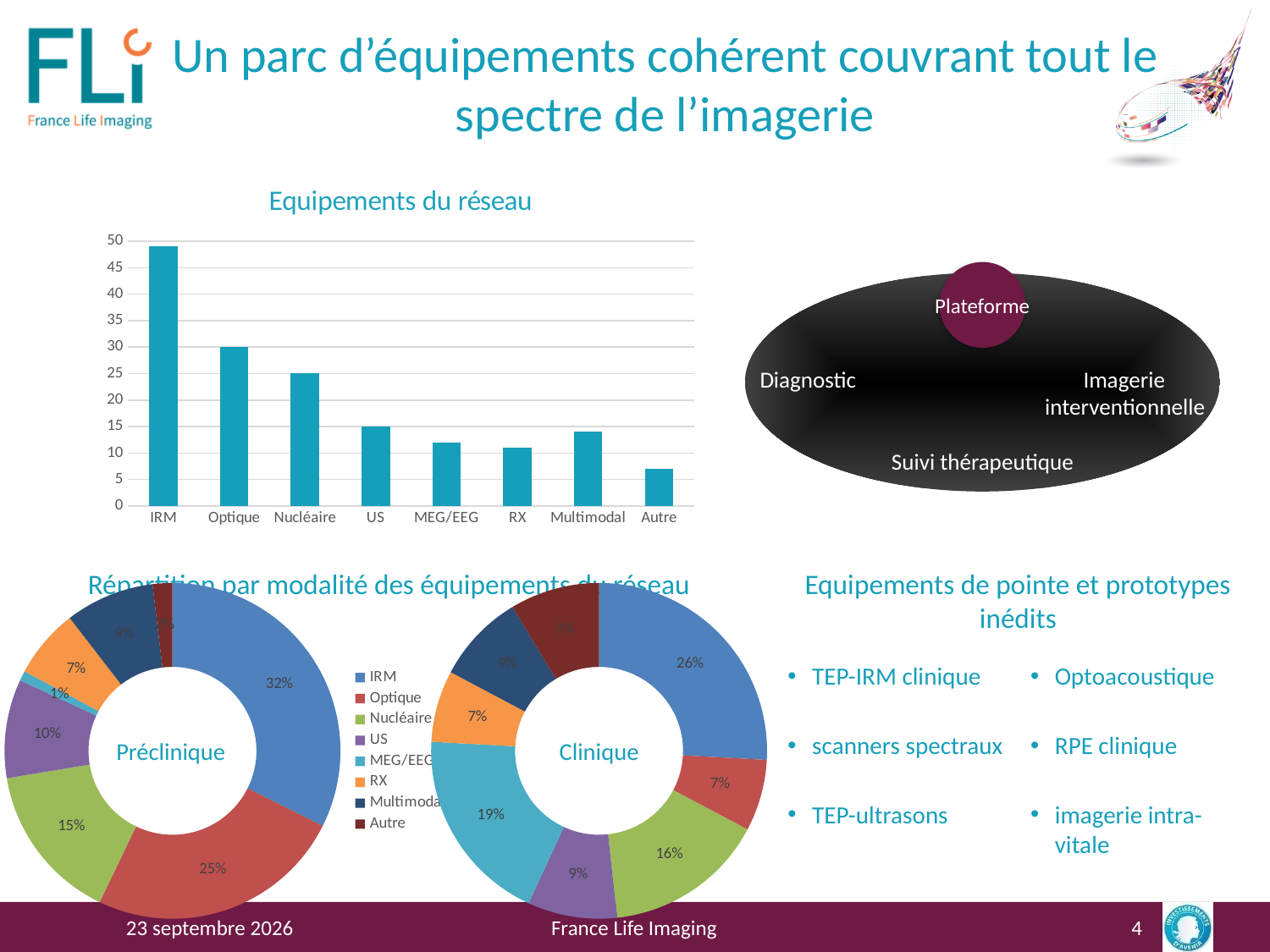
In the 'Clinique' pie chart, what share does MEG/EEG have? 19% In the 'Equipements du réseau' chart, which category has the highest value? IRM In the 'Equipements du réseau' chart, which is larger, Optique or Nucléaire? Optique How many entries does the legend of the 'Répartition par modalité des équipements du réseau' pie charts list? 8 In the 'Equipements du réseau' chart, which category has the lowest value? Autre In the 'Equipements du réseau' chart, what is the value for Optique? 30 In the 'Equipements du réseau' chart, is the value for IRM greater or less than 45? greater What kind of chart is the 'Equipements du réseau' chart? bar chart In the 'Préclinique' pie chart, what share does IRM have? 32% In the 'Equipements du réseau' chart, is the value for Autre greater or less than 10? less How many categories are shown in the 'Equipements du réseau' bar chart? 8 In the 'Clinique' pie chart, which modality has the largest share? IRM